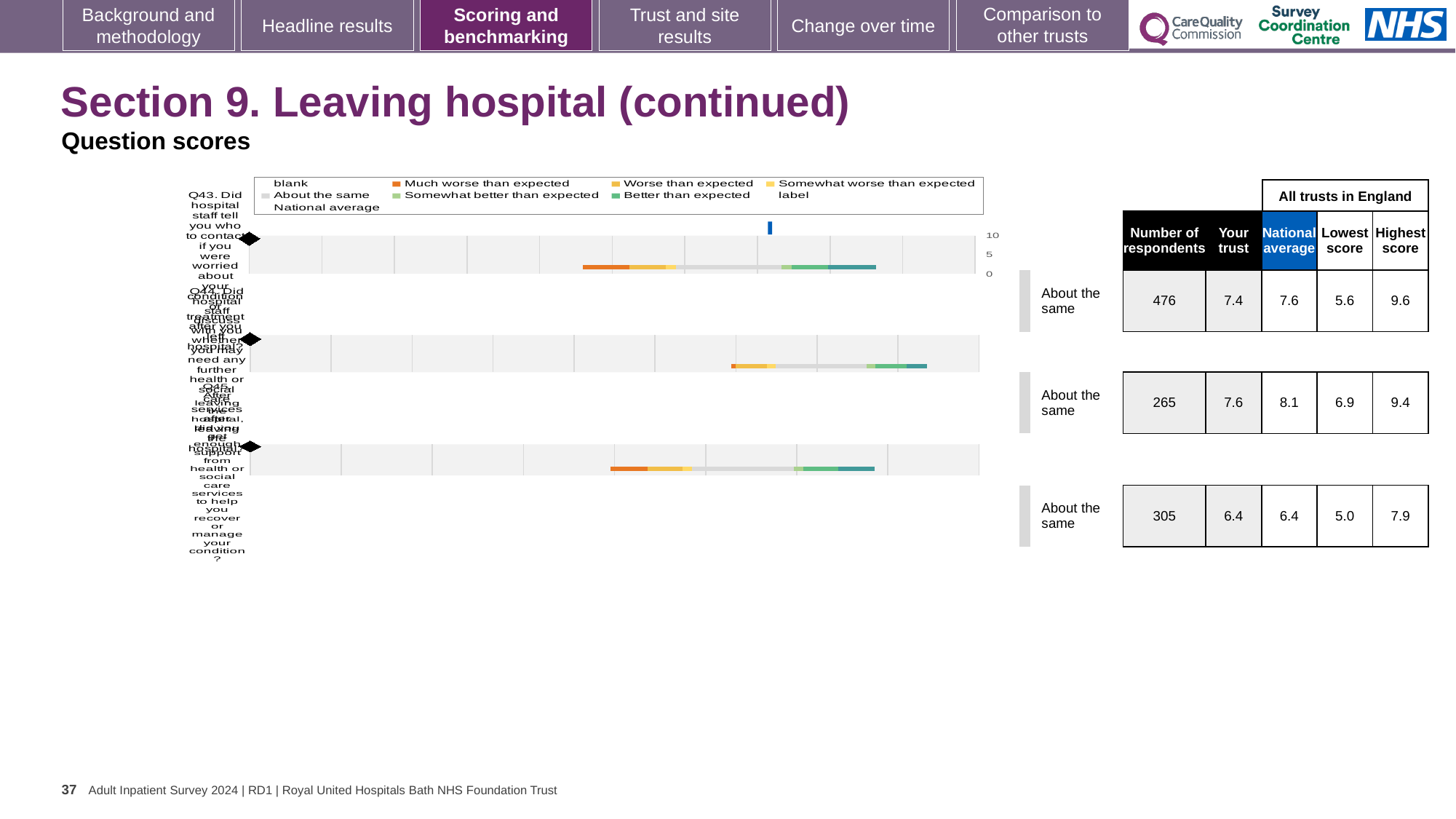
Which of the three charts has the highest 'Your trust' score? The middle chart (7.6) For the middle chart, what is the number of respondents? 265 For the top chart (Q43), what is the difference between the highest score and the lowest score? 4.0 For the top chart (Q43), what is the number of respondents shown in the table? 476 For the top chart (Q43), which is larger: the 'Your trust' score or the national average? National average What kind of chart is used for each question on the slide? bar chart How many question charts are shown on the slide? 3 For the top chart (Q43), what is the 'Your trust' score? 7.4 For the middle chart, what is the highest score among all trusts in England? 9.4 For the top chart (Q43), what is the national average score? 7.6 What benchmark category label is shown beside each of the three charts? About the same For the bottom chart, what is the lowest score among all trusts in England? 5.0